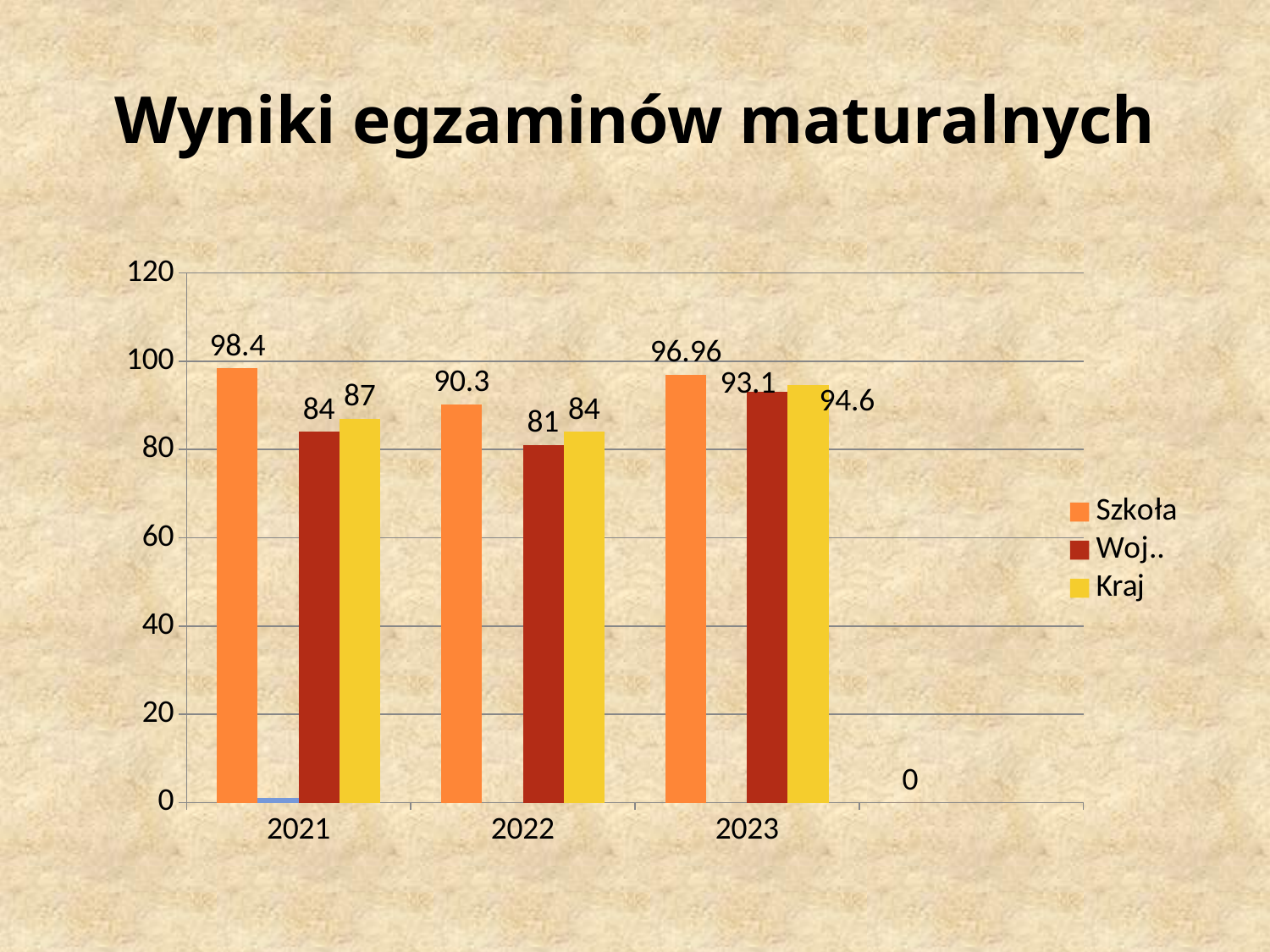
What is the difference between the Kraj and Woj.. values in 2023? 1.5 What is the value for Szkoła in 2023? 96.96 What is the value for Woj.. in 2023? 93.1 In which year is the Woj.. value lowest? 2022 Which is larger in 2022, the Szkoła value or the Kraj value? Szkoła In which year is the Szkoła value highest? 2021 How many series does the legend list? 3 What is the difference between the Szkoła and Woj.. values in 2021? 14.4 What is the value for Kraj in 2022? 84 What kind of chart is shown on the slide? Bar chart What is the value for Szkoła in 2021? 98.4 What is the title of the slide? Wyniki egzaminów maturalnych